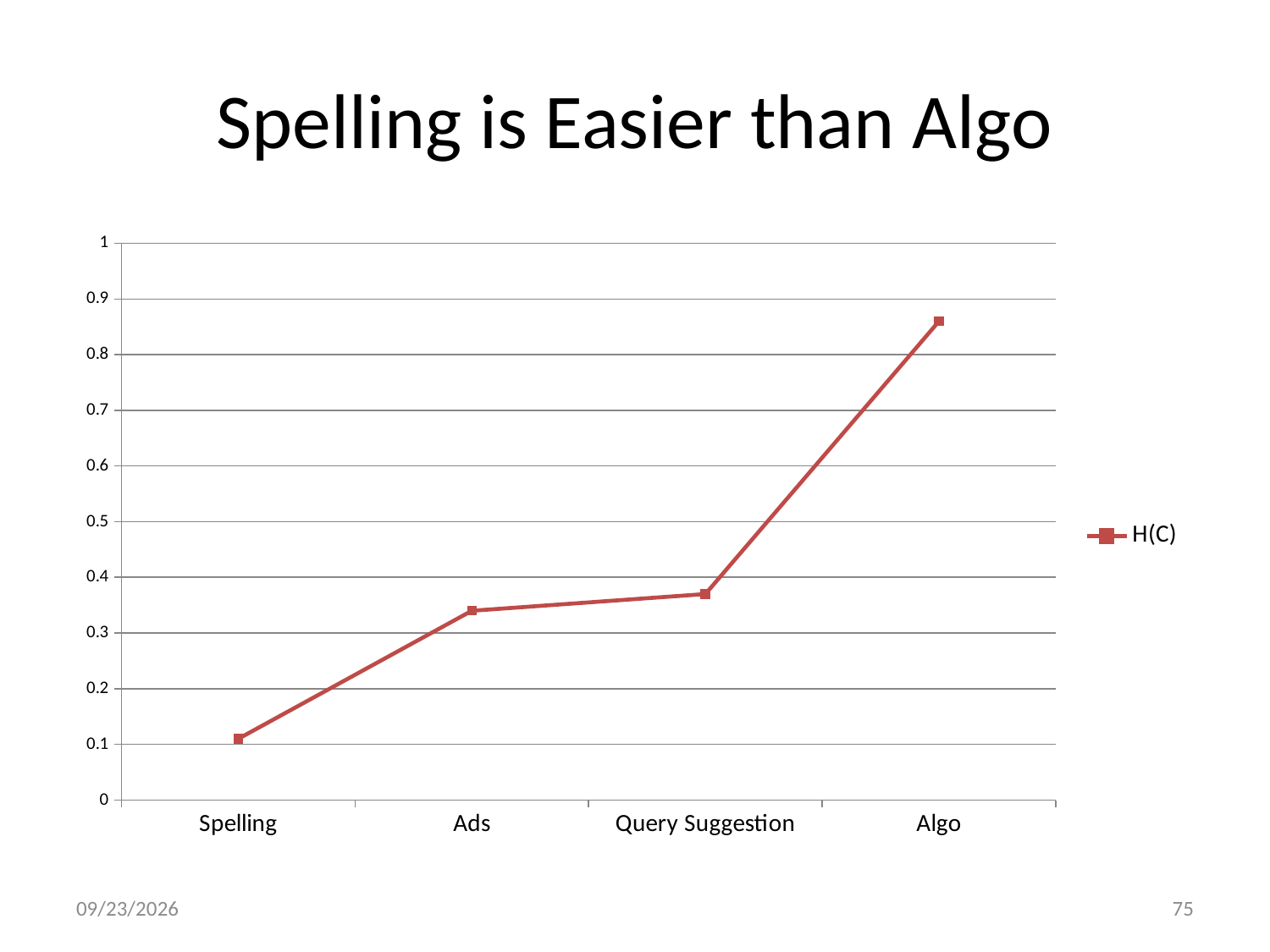
What kind of chart is shown on the slide? line chart How many categories are plotted along the x axis? 4 Which has a larger H(C) value, Spelling or Algo? Algo Do the H(C) values rise or fall from Spelling to Algo along the x axis? rise Is the H(C) value for Query Suggestion greater or less than 0.5? less Is the H(C) value for Spelling greater or less than 0.2? less What is the name of the series shown in the legend? H(C) Which category has the highest H(C) value? Algo Which category has the lowest H(C) value? Spelling How many series does the legend list? 1 Which has a larger H(C) value, Ads or Spelling? Ads Is the H(C) value for Algo greater or less than 0.8? greater